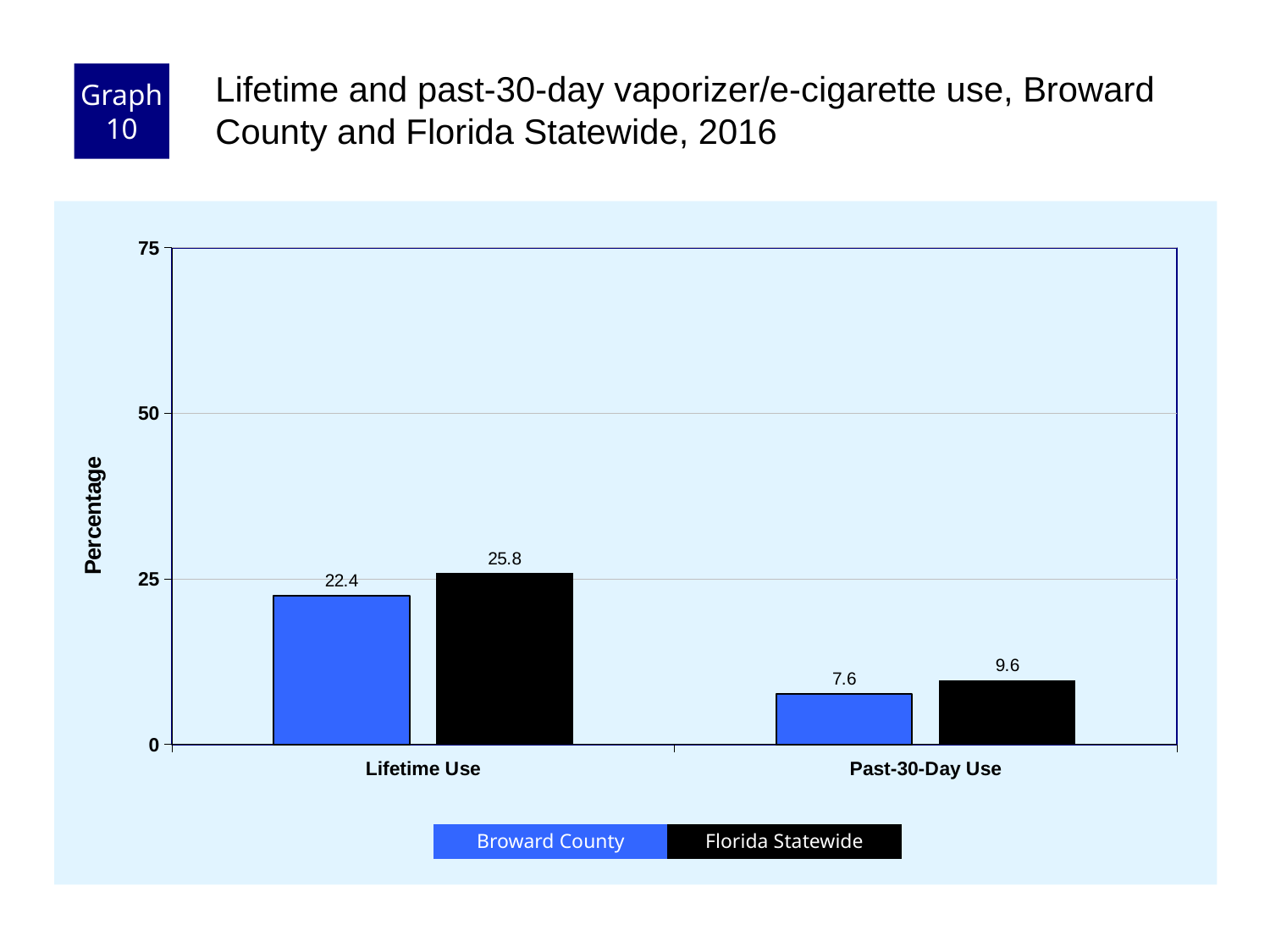
What kind of chart is shown on the slide? Bar chart What is the Broward County value for Past-30-Day Use? 7.6 Which bar has the highest value on the chart? Florida Statewide, Lifetime Use Which bar has the lowest value on the chart? Broward County, Past-30-Day Use For Past-30-Day Use, which is larger: Broward County or Florida Statewide? Florida Statewide How many series does the legend list? 2 What is the Florida Statewide value for Lifetime Use? 25.8 What is the difference between the Florida Statewide and Broward County values for Lifetime Use? 3.4 What is the difference between the Florida Statewide and Broward County values for Past-30-Day Use? 2.0 Is the Florida Statewide value for Lifetime Use greater or less than 25? greater What is the Florida Statewide value for Past-30-Day Use? 9.6 What is the Broward County value for Lifetime Use? 22.4